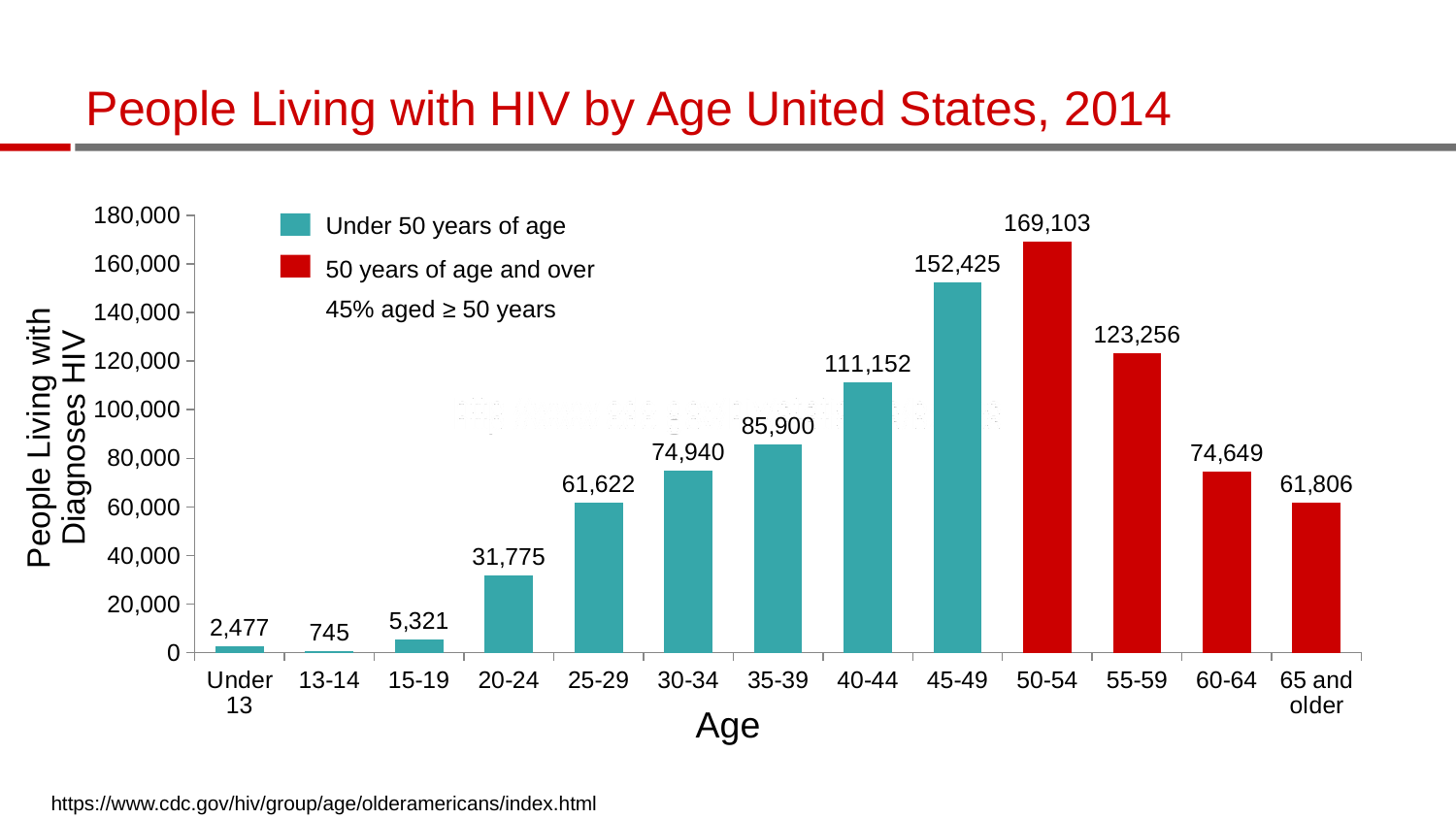
How many age groups are shown on the x axis? 13 How many people living with HIV were aged 45-49? 152,425 What is the value shown for the 13-14 age group? 745 What is the difference between the values for the 50-54 and 45-49 age groups? 16,678 How many series does the legend list? 2 Which age group has a larger value, 20-24 or 60-64? 60-64 Is the value for the 35-39 age group greater or less than 80,000? greater What kind of chart is shown on the slide? bar chart What is the difference between the values for the 55-59 and 40-44 age groups? 12,104 Which age group has the lowest number of people living with HIV? 13-14 What is the value shown for the 65 and older age group? 61,806 Which age group has the highest number of people living with HIV? 50-54